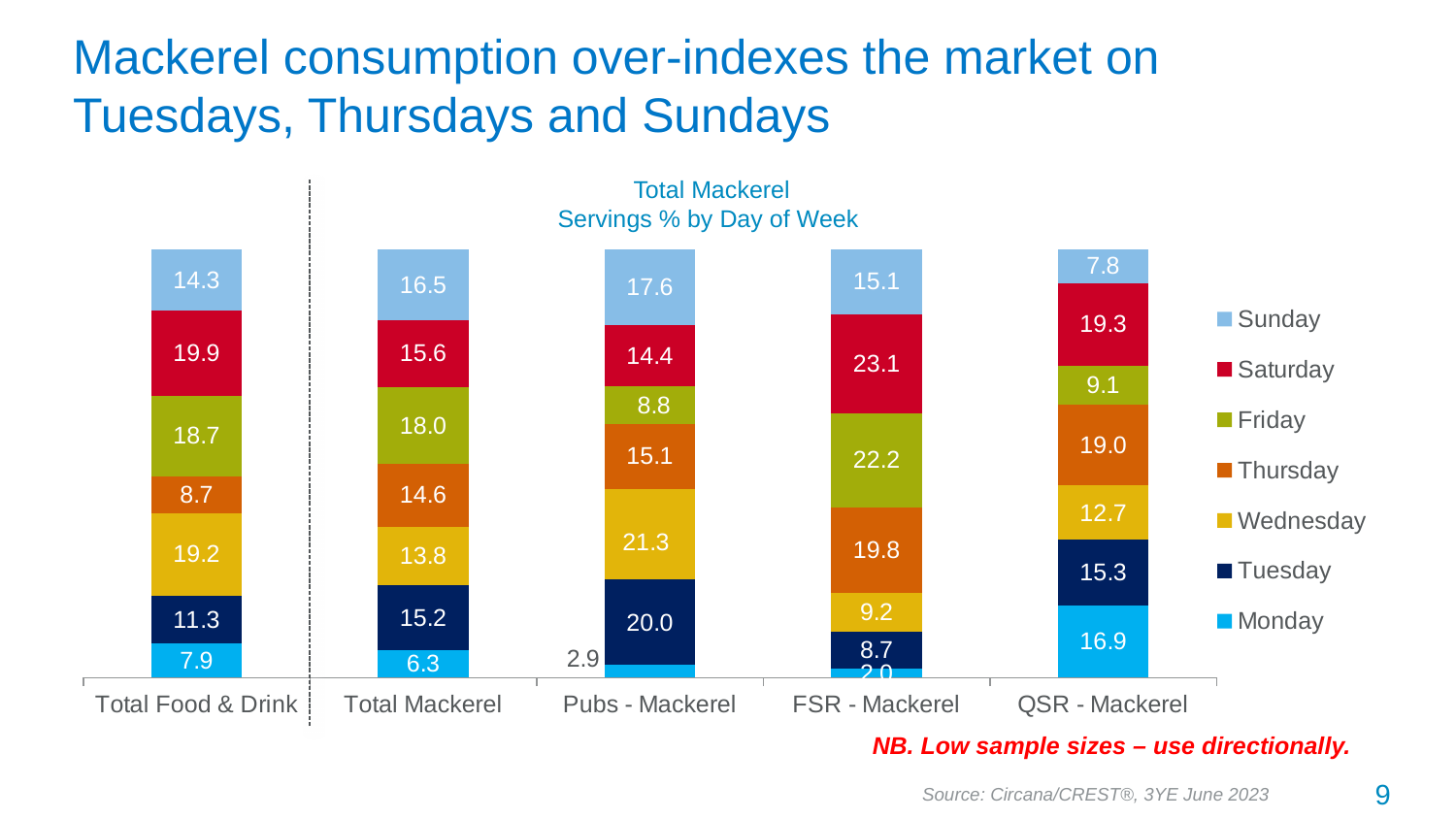
Which is larger, the Sunday value for Pubs - Mackerel or the Sunday value for QSR - Mackerel? Pubs - Mackerel How many categories are shown on the x axis? 5 What is the Sunday value for Total Mackerel? 16.5 What is the Thursday value for Total Food & Drink? 8.7 What is the Saturday value for FSR - Mackerel? 23.1 What is the Monday value for QSR - Mackerel? 16.9 What kind of chart is shown on the slide? Stacked bar chart What is the Wednesday value for Pubs - Mackerel? 21.3 Which day has the lowest value for Total Mackerel? Monday Which day has the highest value for FSR - Mackerel? Saturday How many series does the legend list? 7 What is the difference between the Thursday values for Total Mackerel and Total Food & Drink? 5.9